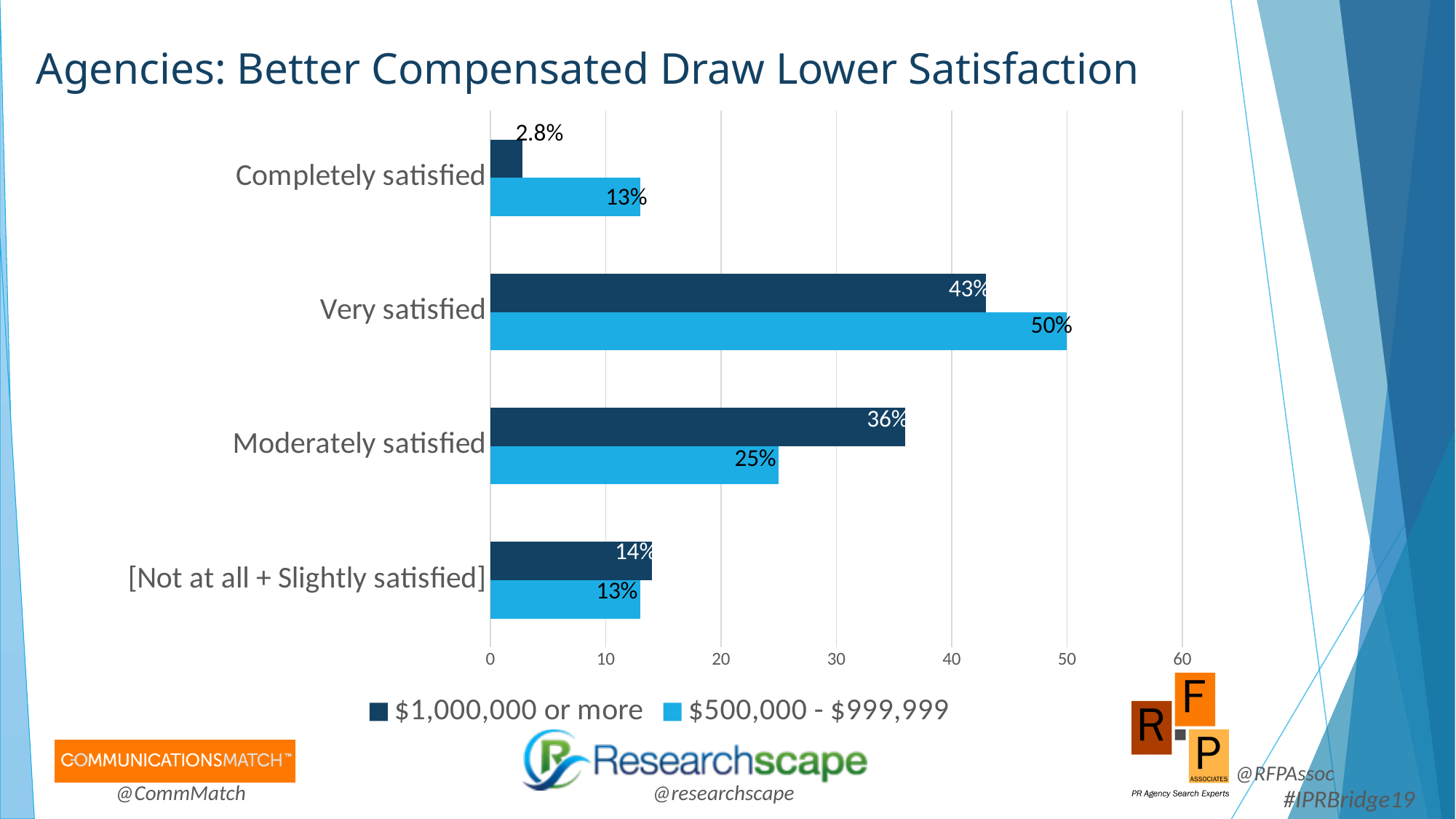
What is the value for Completely satisfied in the $500,000 - $999,999 series? 13% How many series does the legend list? 2 What is the value for Moderately satisfied in the $1,000,000 or more series? 36% How many categories are shown on the chart? 4 Which category has the lowest value in the $1,000,000 or more series? Completely satisfied What kind of chart is shown on the slide? Bar chart What is the value for Very satisfied in the $1,000,000 or more series? 43% What is the difference between the $500,000 - $999,999 and $1,000,000 or more values for Moderately satisfied? 11% What is the value for Completely satisfied in the $1,000,000 or more series? 2.8% For Very satisfied, which series has the larger value: $1,000,000 or more or $500,000 - $999,999? $500,000 - $999,999 Is the value for Very satisfied in the $1,000,000 or more series greater or less than 40? greater Which category has the highest value in the $500,000 - $999,999 series? Very satisfied